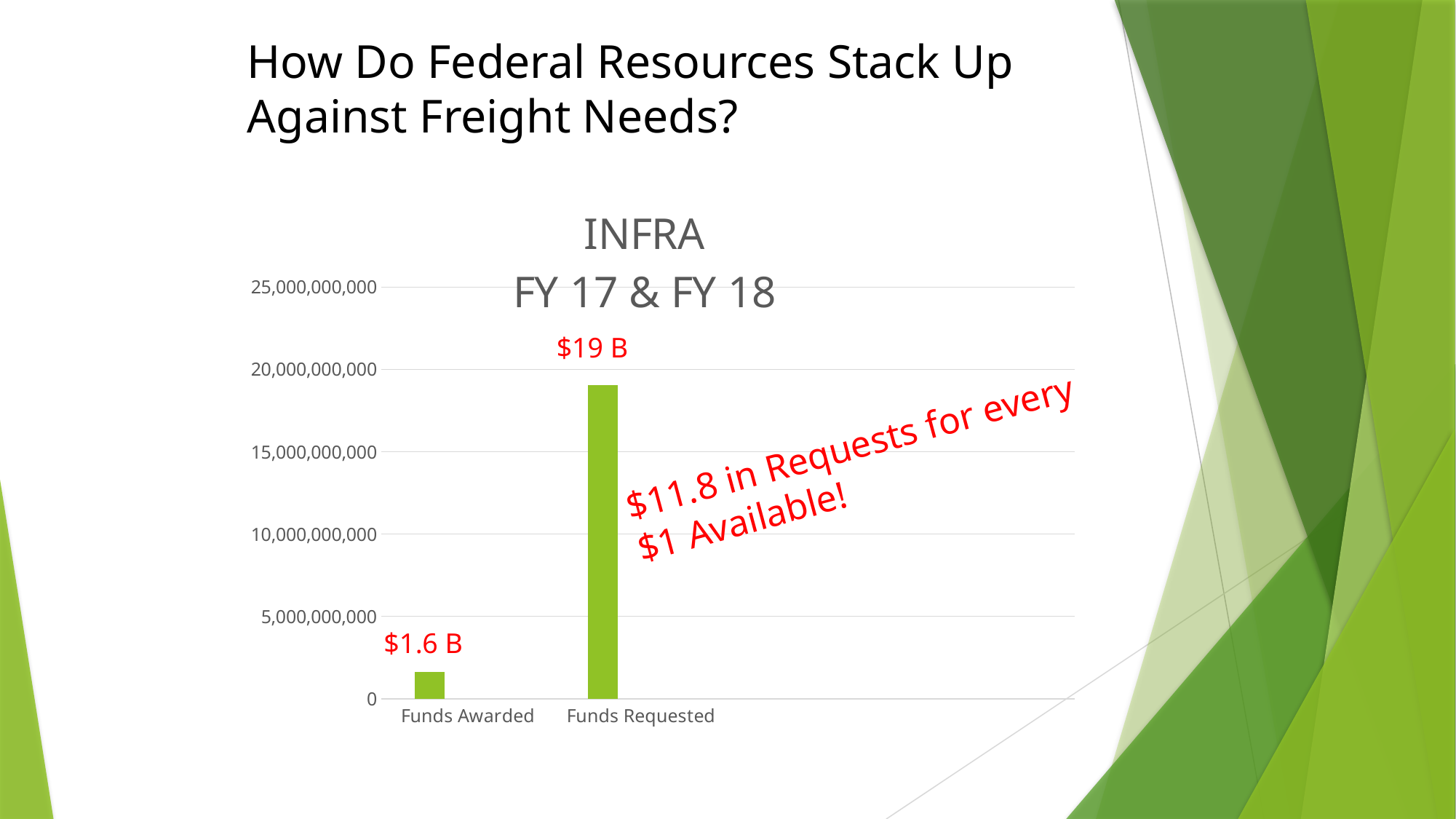
Is the value for Funds Requested greater or less than 20,000,000,000? less What is the highest value labelled on the vertical axis? 25,000,000,000 Which category has the higher value, Funds Awarded or Funds Requested? Funds Requested What is the value shown for Funds Requested? $19 B What kind of chart is shown on the slide? bar chart Is the value for Funds Awarded greater or less than 5,000,000,000? less What is the title of the chart? INFRA FY 17 & FY 18 What is the value shown for Funds Awarded? $1.6 B According to the red annotation, how many dollars in requests are there for every $1 available? $11.8 Is the value for Funds Requested greater or less than 15,000,000,000? greater Which category has the lowest value? Funds Awarded How many categories are shown on the x axis? 2